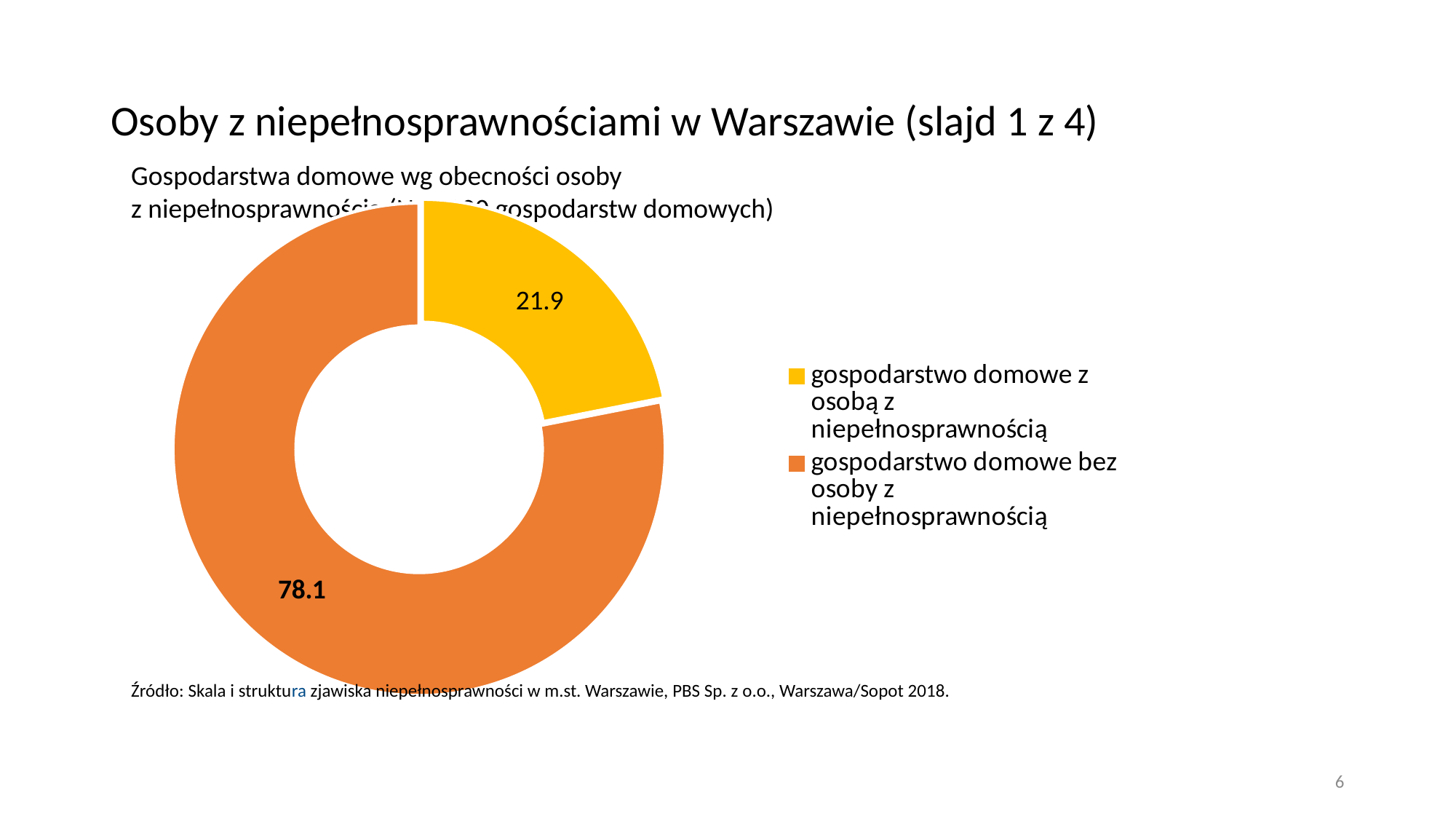
What is the total of the two values shown in the chart? 100 How many entries does the legend list? 2 What value is shown for the slice 'gospodarstwo domowe z osobą z niepełnosprawnością'? 21.9 Which category has the largest slice in the chart? gospodarstwo domowe bez osoby z niepełnosprawnością What colour is the slice for 'gospodarstwo domowe z osobą z niepełnosprawnością'? yellow How many categories are shown in the chart? 2 Which is larger: the slice for 'gospodarstwo domowe z osobą z niepełnosprawnością' or the slice for 'gospodarstwo domowe bez osoby z niepełnosprawnością'? gospodarstwo domowe bez osoby z niepełnosprawnością What colour is the slice for 'gospodarstwo domowe bez osoby z niepełnosprawnością'? orange What value is shown for the slice 'gospodarstwo domowe bez osoby z niepełnosprawnością'? 78.1 What is the difference between the values for households without a person with a disability and households with a person with a disability? 56.2 What kind of chart is shown on the slide? doughnut (pie) chart Which category has the smallest slice in the chart? gospodarstwo domowe z osobą z niepełnosprawnością